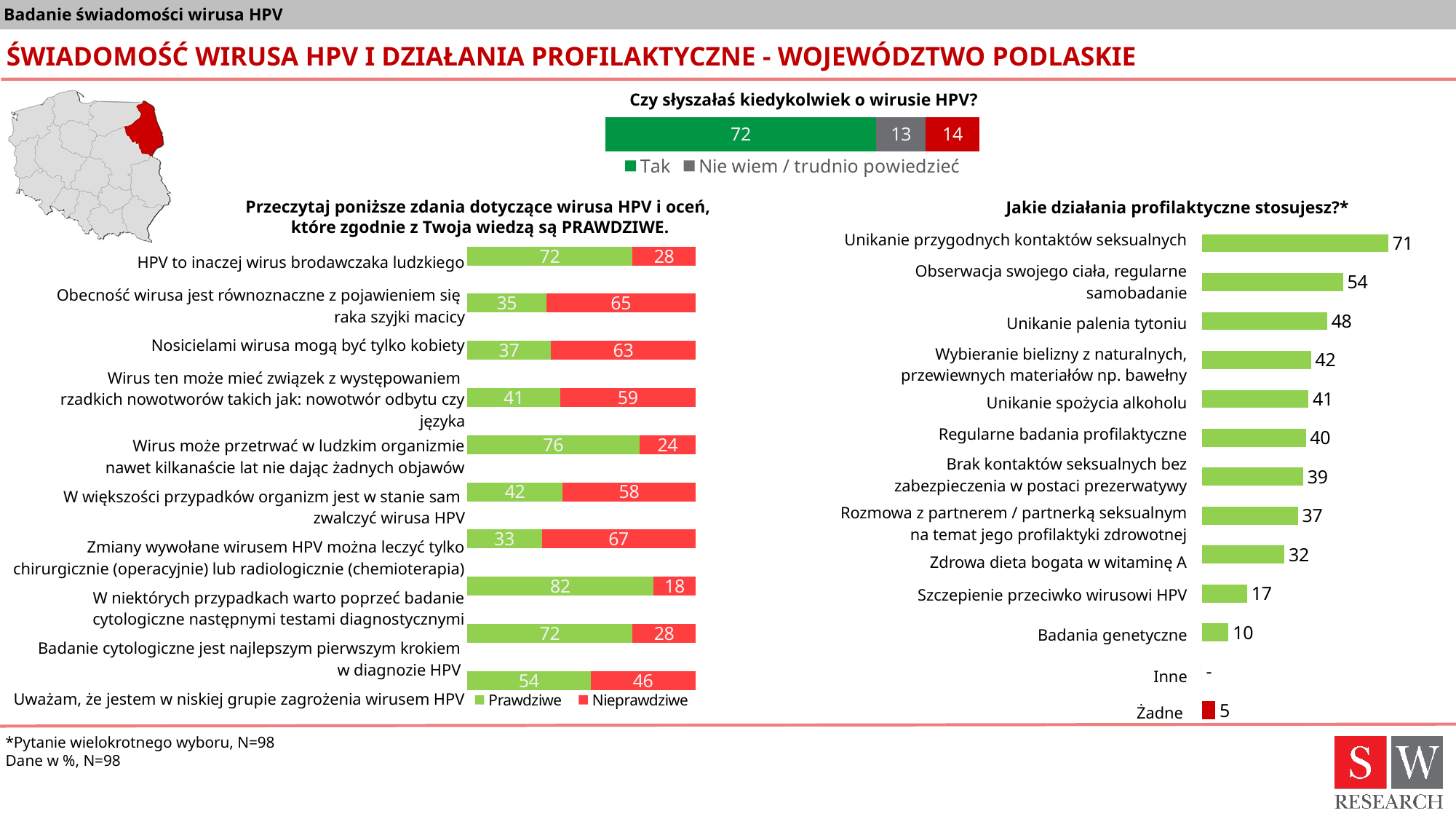
In the chart 'Jakie działania profilaktyczne stosujesz?', what is the value for 'Szczepienie przeciwko wirusowi HPV'? 17 In the chart 'Jakie działania profilaktyczne stosujesz?', which is larger: 'Unikanie spożycia alkoholu' or 'Zdrowa dieta bogata w witaminę A'? Unikanie spożycia alkoholu In the chart 'Jakie działania profilaktyczne stosujesz?', what is the difference between 'Unikanie przygodnych kontaktów seksualnych' and 'Obserwacja swojego ciała, regularne samobadanie'? 17 In the chart 'Czy słyszałaś kiedykolwiek o wirusie HPV?', what is the value for 'Tak'? 72 In the chart 'Jakie działania profilaktyczne stosujesz?', what is the value for 'Żadne'? 5 In the chart 'Przeczytaj poniższe zdania dotyczące wirusa HPV...', what percentage considered 'HPV to inaczej wirus brodawczaka ludzkiego' to be Prawdziwe? 72 What kind of chart is 'Jakie działania profilaktyczne stosujesz?'? Bar chart How many series does the legend of the chart 'Przeczytaj poniższe zdania dotyczące wirusa HPV...' list? 2 In the chart 'Jakie działania profilaktyczne stosujesz?', which category has the highest value? Unikanie przygodnych kontaktów seksualnych In the chart 'Przeczytaj poniższe zdania dotyczące wirusa HPV...', what is the Nieprawdziwe value for 'Uważam, że jestem w niskiej grupie zagrożenia wirusem HPV'? 46 In the chart 'Jakie działania profilaktyczne stosujesz?', what is the value for 'Unikanie palenia tytoniu'? 48 In the chart 'Czy słyszałaś kiedykolwiek o wirusie HPV?', what is the value for 'Nie wiem / trudnio powiedzieć'? 13